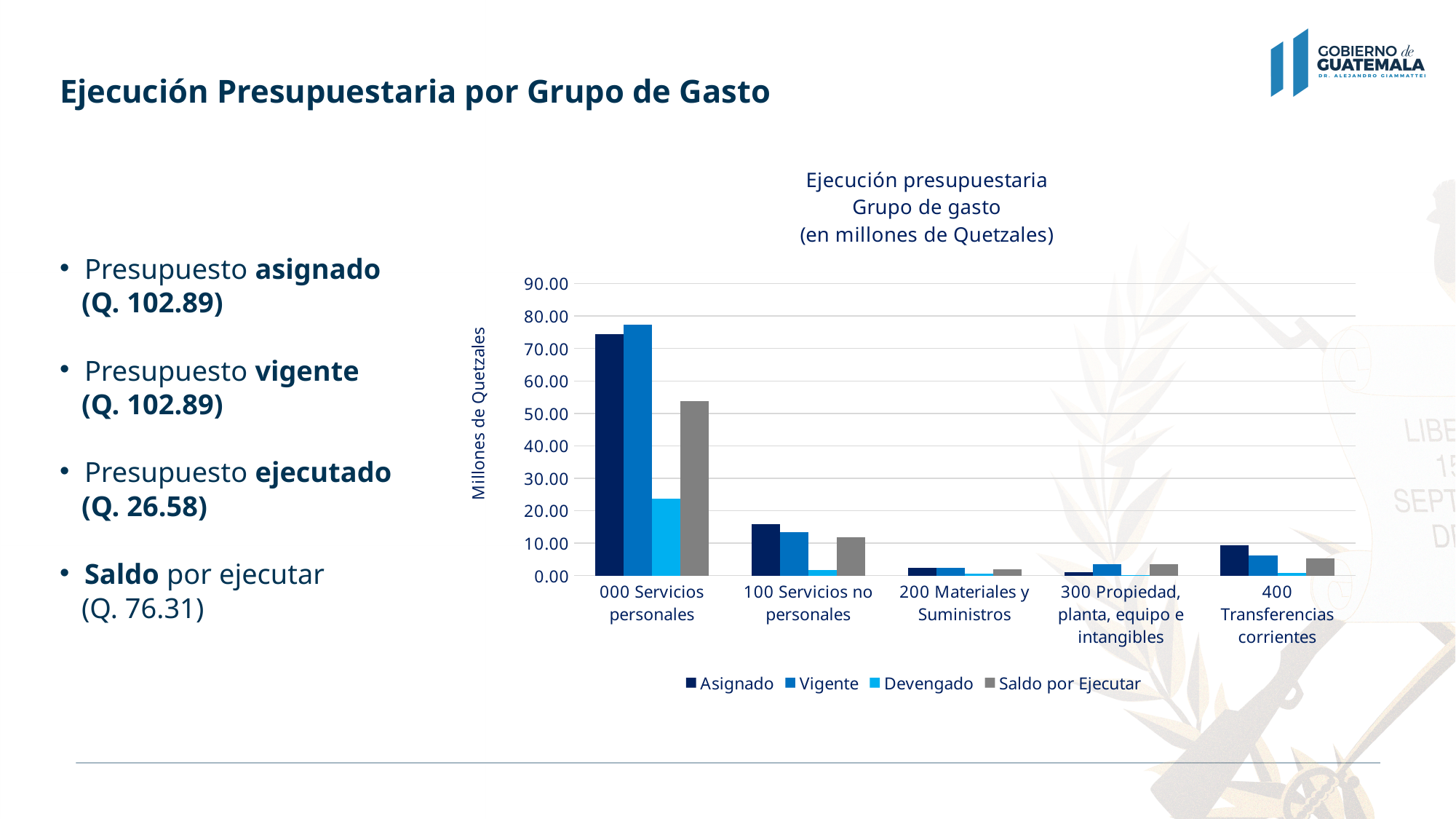
Is the Saldo por Ejecutar value for 000 Servicios personales greater or less than 50.00? greater How many series does the chart legend list? 4 For 400 Transferencias corrientes, which is larger: Asignado or Vigente? Asignado How many expense group categories are shown on the x axis of the chart? 5 Is the Devengado value for 000 Servicios personales greater or less than 30.00? less What is the title of the vertical axis of the chart? Millones de Quetzales Is the Vigente value for 000 Servicios personales greater or less than 70.00? greater For 100 Servicios no personales, which is larger: Asignado or Vigente? Asignado What kind of chart is shown on the slide? bar chart Which category has the lowest Asignado value? 300 Propiedad, planta, equipo e intangibles Which category has the highest Vigente value? 000 Servicios personales